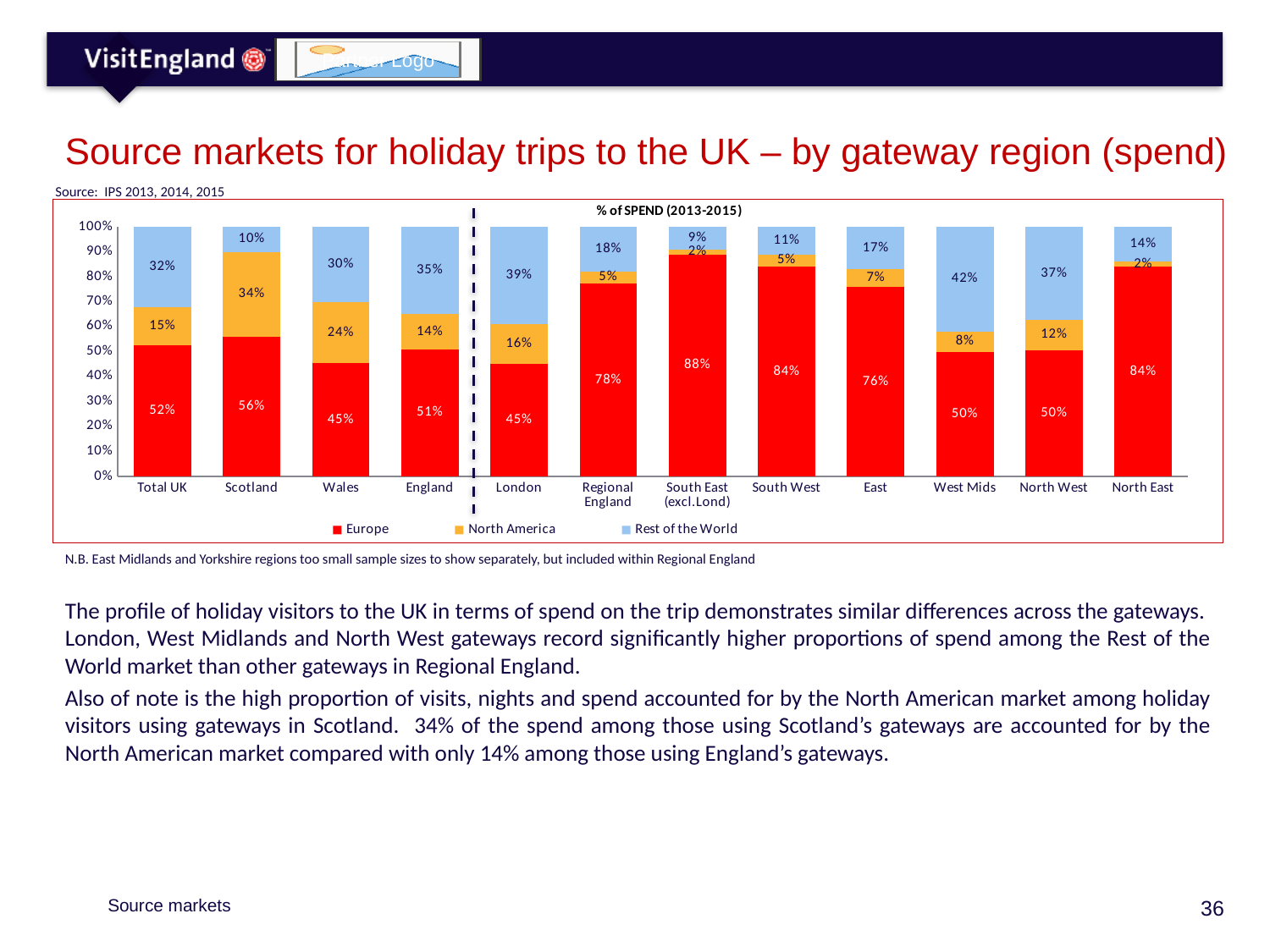
Which gateway region has the highest North America share of spend? Scotland What is the Europe share of spend for the South East (excl. Lond) gateway? 88% How many gateway regions are shown on the x axis of the chart? 12 How many percentage points higher is the North America share of spend for Scotland than for England? 20 percentage points What is the Rest of the World share of spend for the West Mids gateway? 42% Which gateway region has the lowest Rest of the World share of spend? South East (excl. Lond) How many series does the chart's legend list? 3 What type of chart is used to show the % of spend by gateway region? Stacked bar chart Which has a larger Rest of the World share of spend, London or North West? London Which gateway region has the highest Europe share of spend? South East (excl. Lond) What is the North America share of spend for Total UK? 15% What percentage of spend for the Scotland gateway comes from North America? 34%